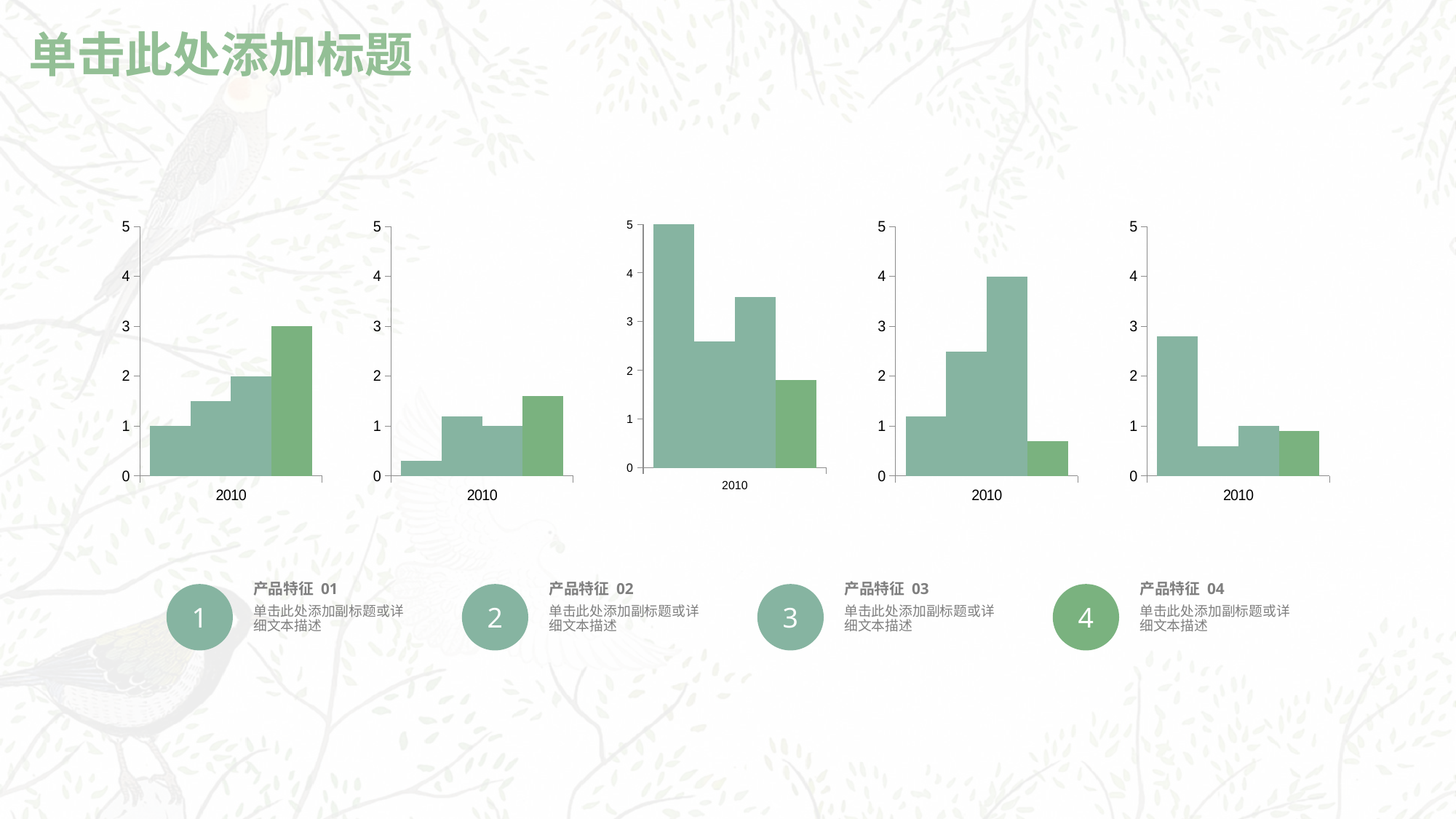
In the middle (third) chart, what is the value of the leftmost bar? 5 In the leftmost chart, what is the value of the rightmost (darker green) bar? 3 In the leftmost chart, what is the value of the leftmost bar? 1 In the fourth chart from the left, is the rightmost bar greater or less than 1? less How many bar charts are shown on the slide? 5 In the rightmost chart, is the value of the leftmost bar greater or less than 2? greater In the middle (third) chart, which bar is the lowest? the rightmost bar What is the x-axis category label shown under each chart? 2010 In the leftmost chart, how many bars are plotted for the 2010 category? 4 In the second chart from the left, is the value of the leftmost bar greater or less than 1? less What type of chart is the leftmost chart on the slide? bar chart In the fourth chart from the left, what is the value of the tallest bar? 4